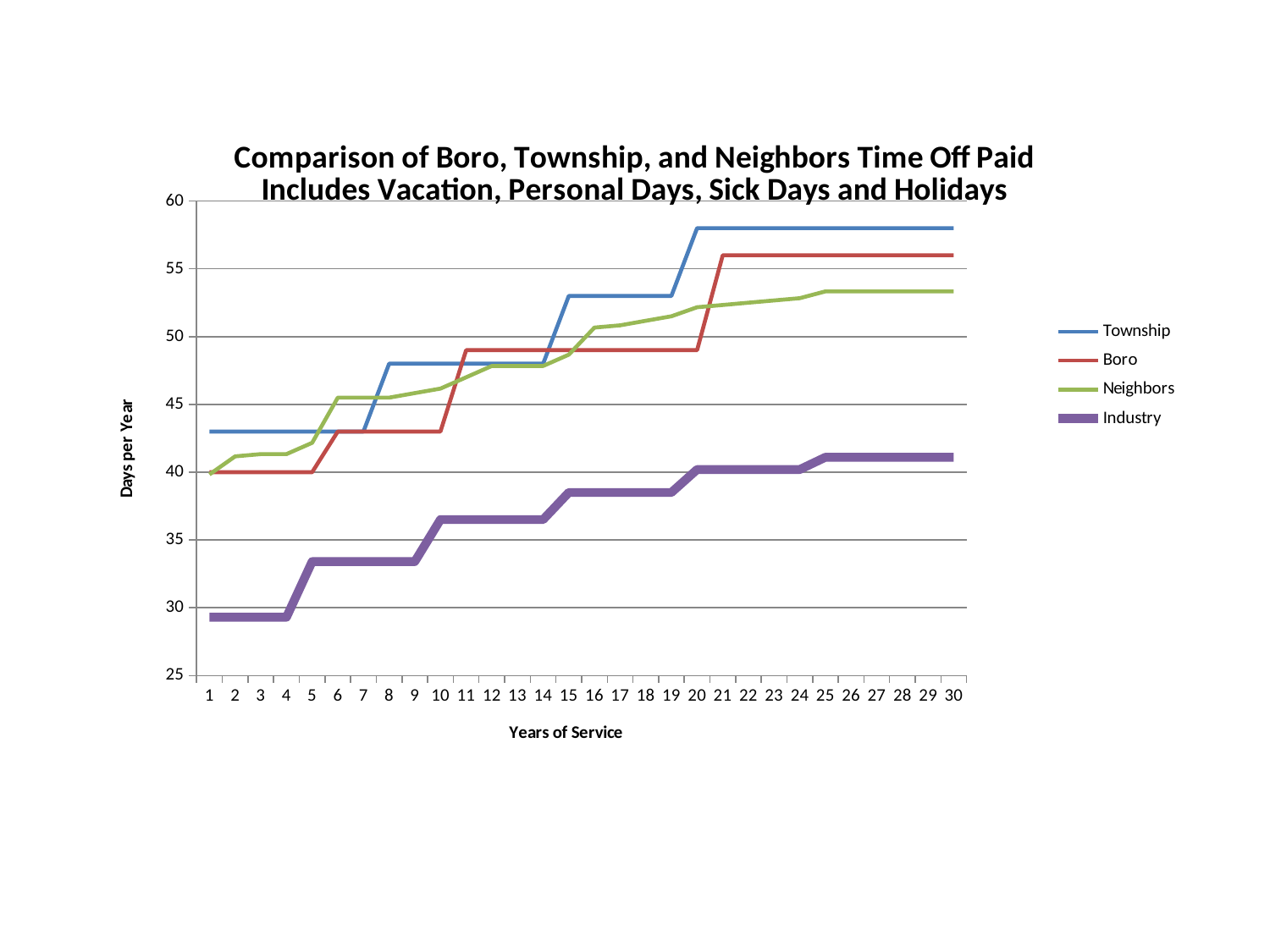
How many series does the legend list? 4 Do the values for Industry rise or fall as years of service increase? rise Is the value for Neighbors at 30 years of service greater or less than 55? less Which series has the lowest value at 30 years of service? Industry Is the value for Township at 30 years of service greater or less than 55? greater What kind of chart is shown on the slide? line chart Is the value for Industry at 1 year of service greater or less than 30? less What is the label on the y axis? Days per Year Which series has the highest value at 30 years of service? Township At 30 years of service, which is larger, Boro or Neighbors? Boro How many years of service are plotted along the x axis? 30 Which series has the lowest value at 1 year of service? Industry